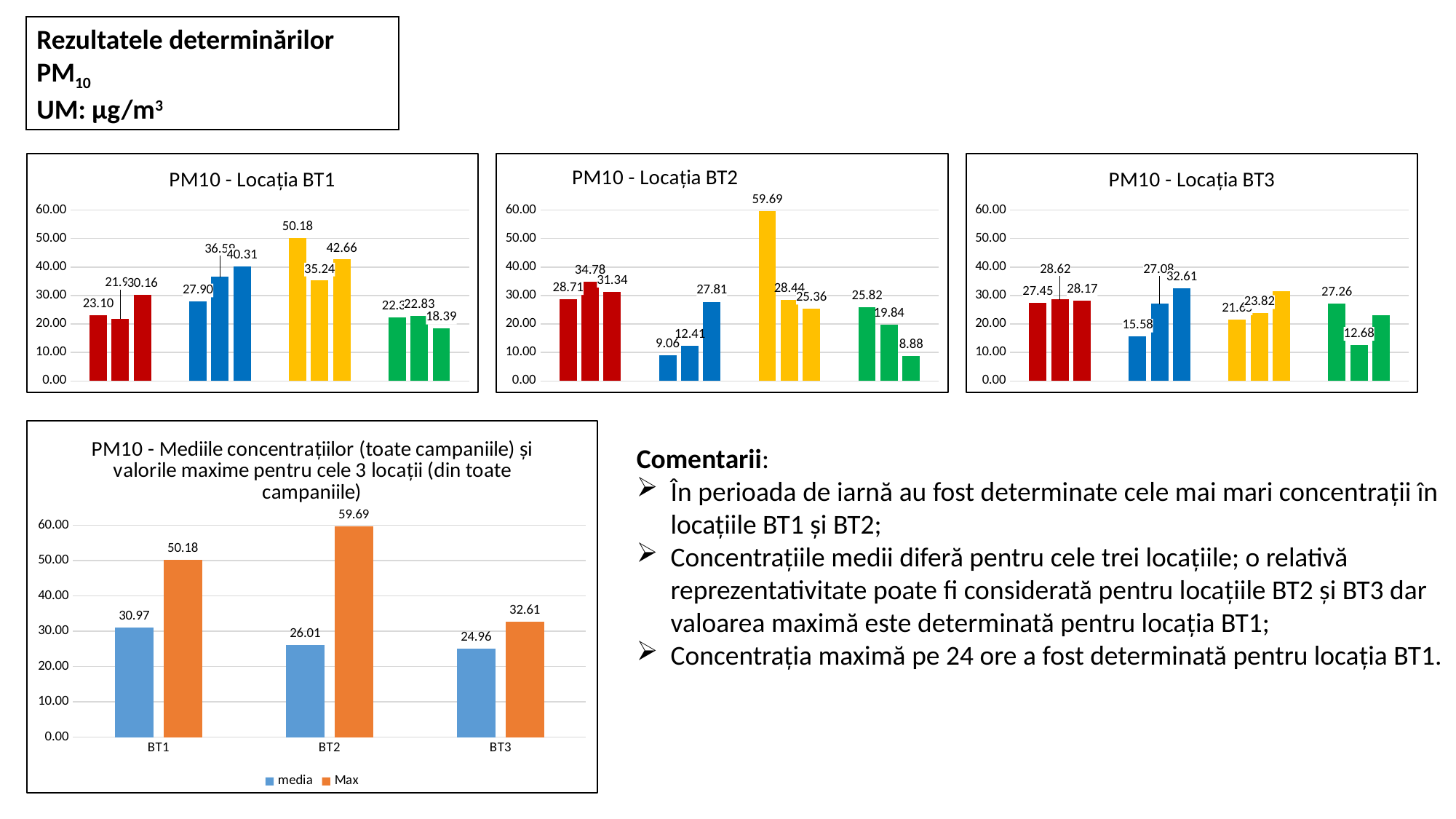
In the bottom-left chart, what is the 'Max' value for BT3? 32.61 In the bottom-left chart, which is larger: the 'media' value for BT1 or the 'media' value for BT2? BT1 What type of chart is 'PM10 - Locația BT1'? bar chart In the bottom-left chart, how many locations are shown on the x axis? 3 In the bottom-left chart, how many series does the legend list? 2 In the chart 'PM10 - Mediile concentrațiilor (toate campaniile) și valorile maxime pentru cele 3 locații', what is the 'media' value for BT2? 26.01 In the chart 'PM10 - Locația BT1', what is the highest labeled value? 50.18 In the bottom-left chart, what are the two legend entries? media, Max In the bottom-left chart, what is the difference between the 'Max' and 'media' values for BT1? 19.21 In the chart 'PM10 - Locația BT2', what is the highest labeled value? 59.69 In the bottom-left chart, which location has the highest 'Max' value? BT2 In the bottom-left chart, which location has the lowest 'media' value? BT3